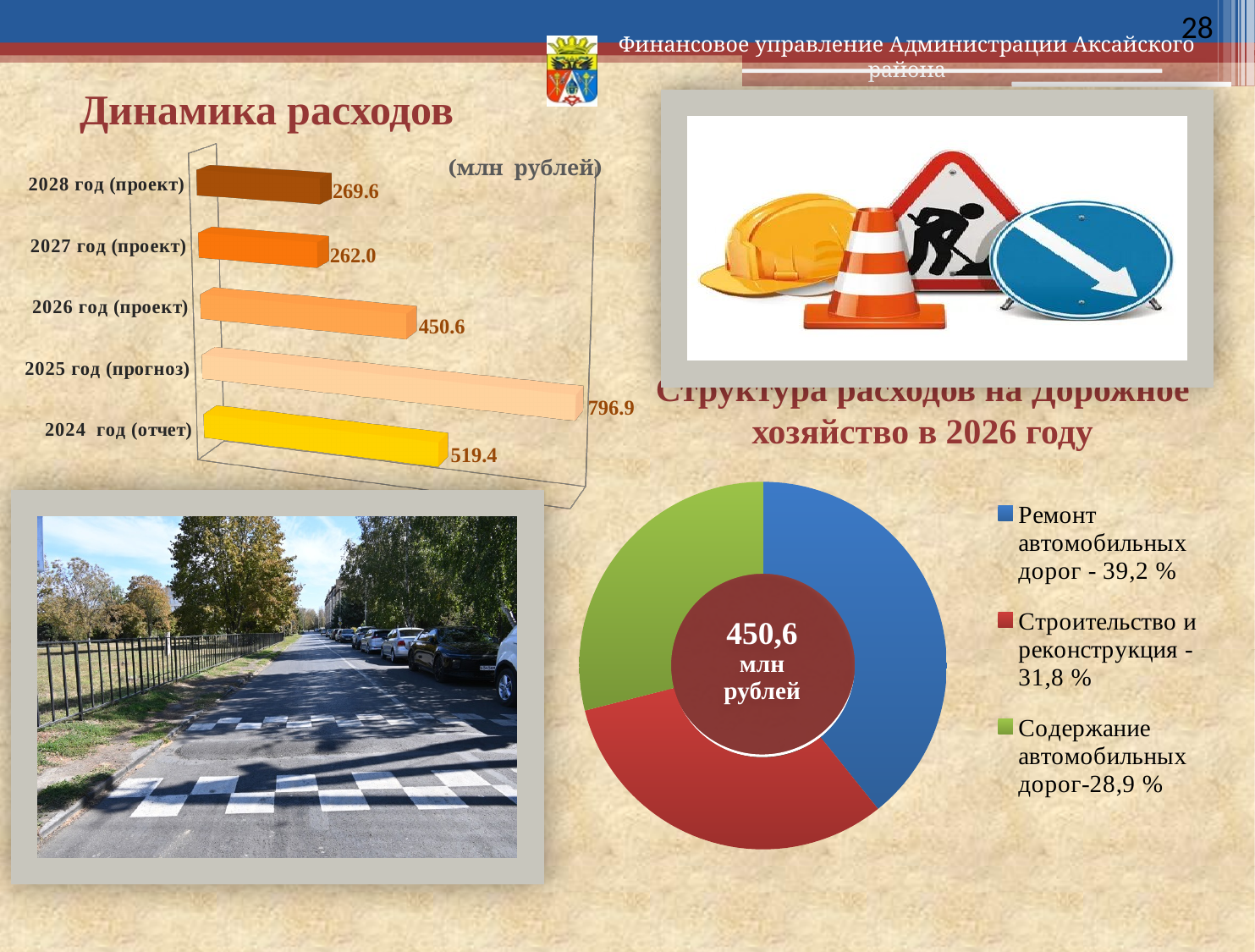
What total amount is shown in the centre of the 'Структура расходов на дорожное хозяйство в 2026 году' chart? 450,6 млн рублей In the 'Динамика расходов' chart, which year has the lowest value? 2027 год (проект) In the 'Динамика расходов' chart, what is the value for 2024 год (отчет)? 519.4 What type of chart is 'Динамика расходов'? Bar chart In the 'Динамика расходов' chart, which is larger: the value for 2024 год (отчет) or 2026 год (проект)? 2024 год (отчет) In the 'Динамика расходов' chart, which year has the highest value? 2025 год (прогноз) In the 'Структура расходов на дорожное хозяйство в 2026 году' chart, what share is 'Ремонт автомобильных дорог'? 39,2 % How many categories does the legend of the 'Структура расходов на дорожное хозяйство в 2026 году' chart list? 3 In the 'Динамика расходов' chart, what is the value for 2025 год (прогноз)? 796.9 How many bars are shown in the 'Динамика расходов' chart? 5 In the 'Структура расходов на дорожное хозяйство в 2026 году' chart, which category has the smallest share? Содержание автомобильных дорог In the 'Динамика расходов' chart, what is the difference between the values for 2025 год (прогноз) and 2026 год (проект)? 346.3